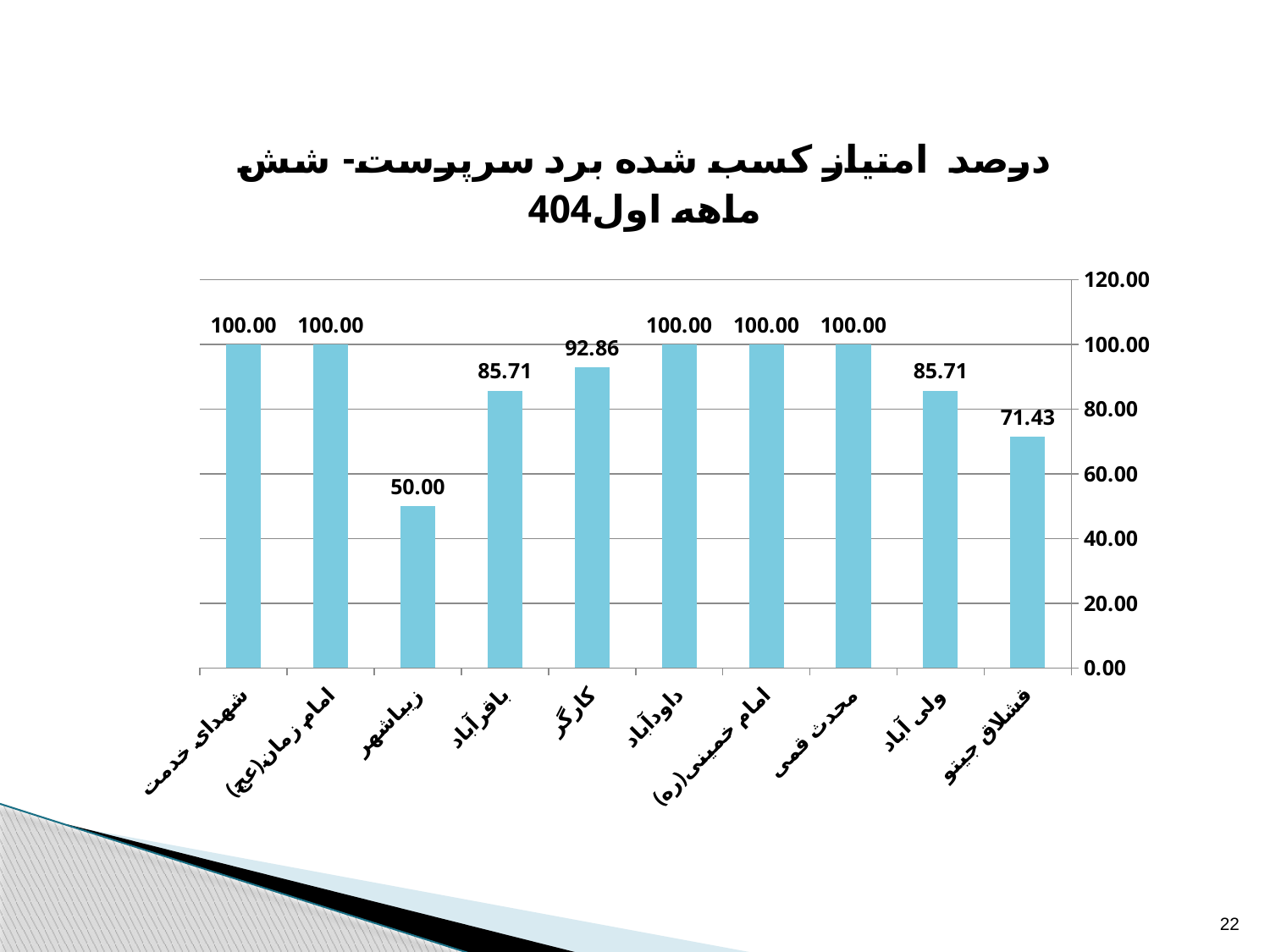
What is the difference between the values for ولی آباد and قشلاق جیتو? 14.28 What is the value for کارگر? 92.86 Which is larger, the value for کارگر or the value for باقرآباد? کارگر What is the difference between the values for کارگر and زیباشهر? 42.86 How many categories have a value of 100.00? 5 What is the value for باقرآباد? 85.71 Which category has the lowest value? زیباشهر What kind of chart is shown on the slide? bar chart What is the value for قشلاق جیتو? 71.43 Is the value for قشلاق جیتو greater or less than 80.00? less What is the value for زیباشهر? 50.00 How many categories are shown on the x axis? 10